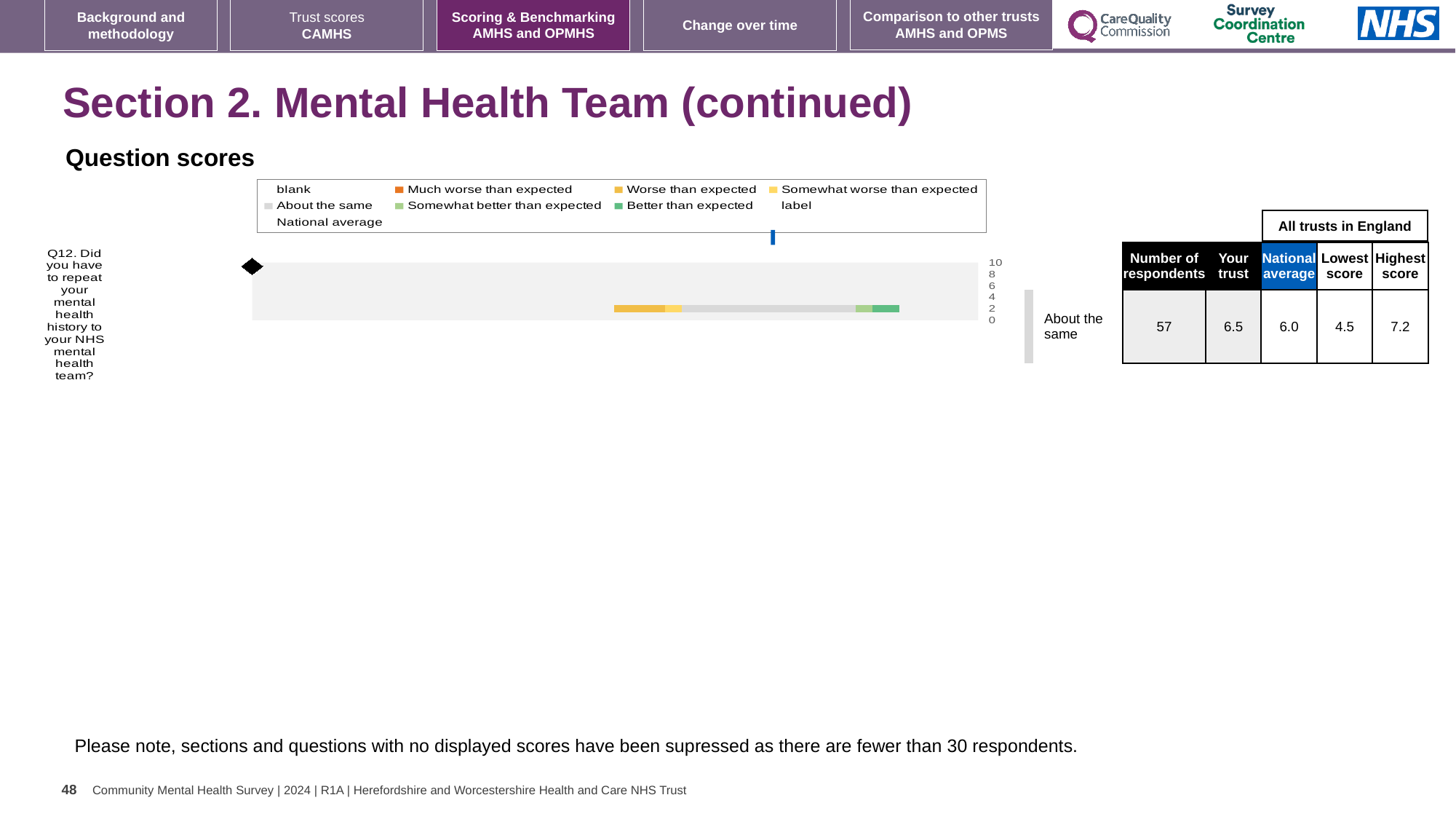
How many survey questions are plotted in the Question scores chart? 1 Which question is plotted in the Question scores chart? Q12. Did you have to repeat your mental health history to your NHS mental health team? What is the difference between the highest score and the lowest score for Q12? 2.7 What is the national average score for Q12? 6.0 What is the lowest score among all trusts in England for Q12? 4.5 What colour does the legend use for 'Better than expected'? green For Q12, which is larger: the 'Your trust' score or the national average? Your trust What is the 'Your trust' score for Q12? 6.5 How many respondents answered Q12? 57 What is the highest score among all trusts in England for Q12? 7.2 What benchmark category is shown next to the bar for Q12? About the same What kind of chart is used to show the Q12 question score? bar chart